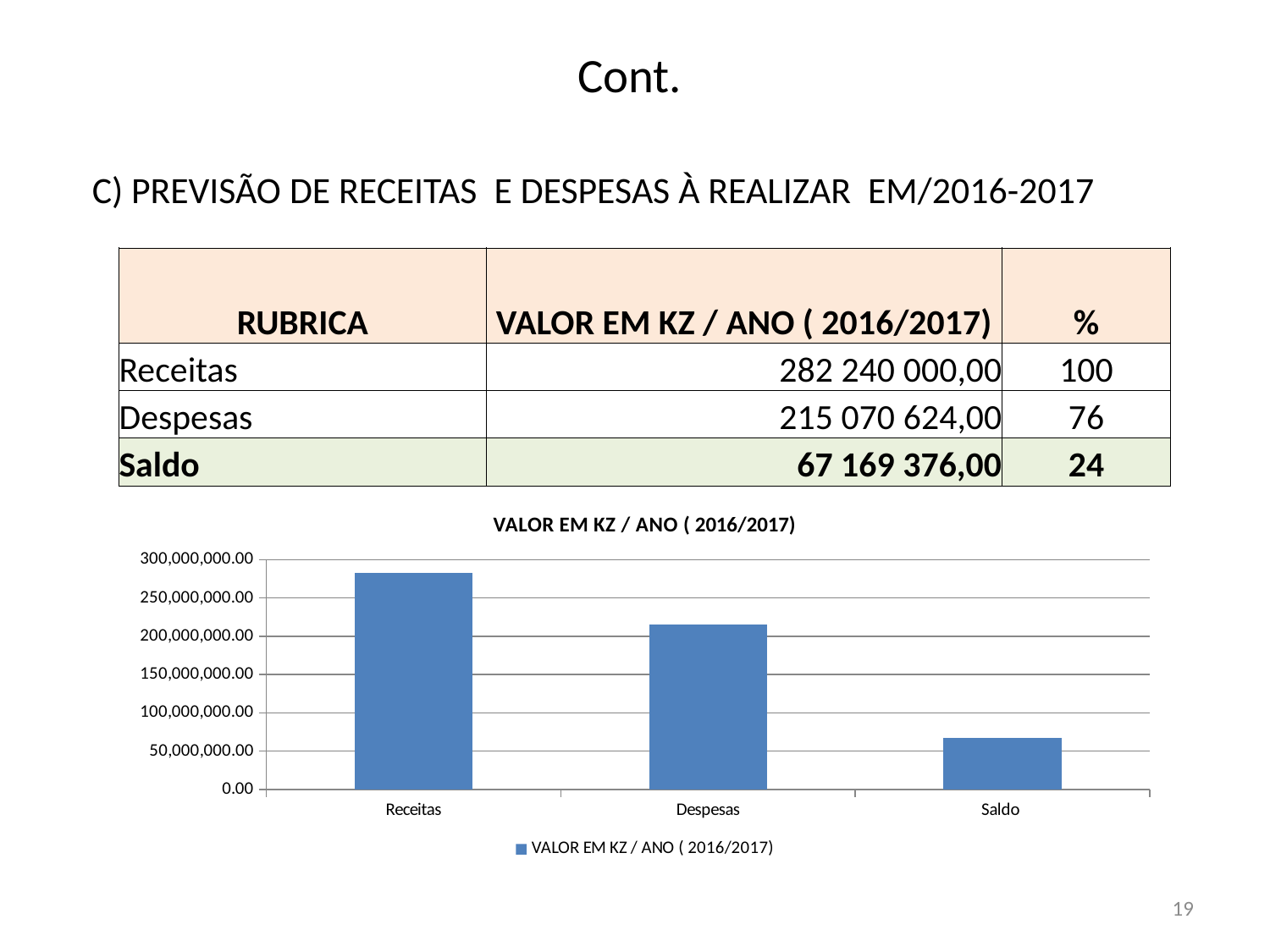
What kind of chart is shown on the slide? bar chart How many series does the chart legend list? 1 Is the value for Saldo greater or less than 100,000,000.00? less Is the value for Despesas greater or less than 200,000,000.00? greater What is the title of the chart? VALOR EM KZ / ANO ( 2016/2017) Which is larger in the chart, Despesas or Saldo? Despesas Is the value for Receitas greater or less than 250,000,000.00? greater How many categories are plotted on the x axis of the chart? 3 What is the value for Receitas shown in the table above the chart? 282 240 000,00 Which category has the highest bar in the chart? Receitas Which category has the lowest bar in the chart? Saldo Do the bar values rise or fall from left to right along the x axis? fall